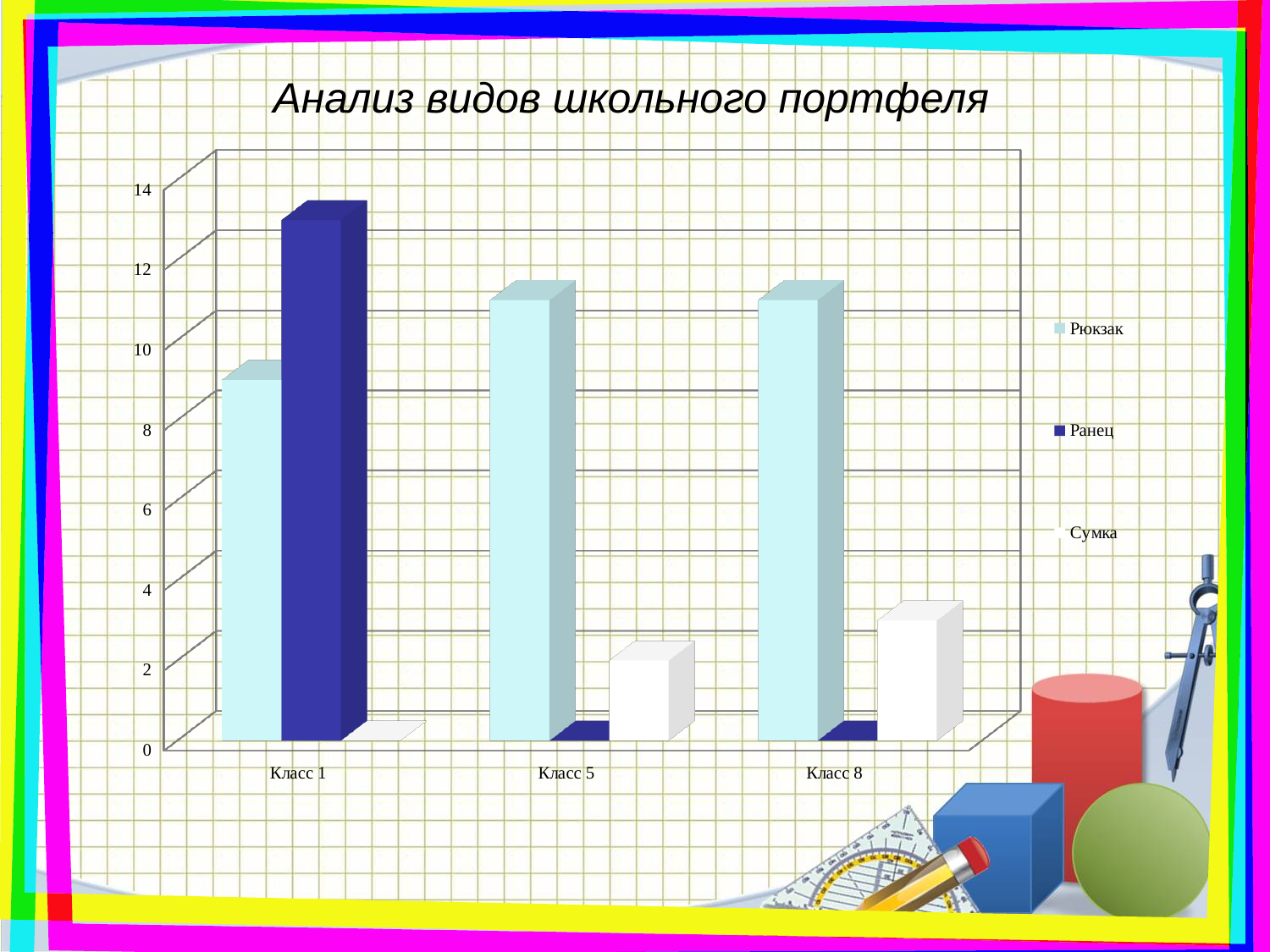
What is the title of the chart? Анализ видов школьного портфеля Is the value of Ранец for Класс 1 greater or less than 12? greater For Класс 5, which is larger: Рюкзак or Сумка? Рюкзак What kind of chart is shown on the slide? bar chart Which class has the larger Сумка value: Класс 5 or Класс 8? Класс 8 Which series has the lowest value for Класс 1? Сумка How many series does the legend list? 3 Which series has the tallest bar for Класс 1? Ранец Is the value of Рюкзак for Класс 1 greater or less than 10? less How many classes (categories) are shown on the x axis? 3 Is the value of Рюкзак for Класс 5 greater or less than 10? greater